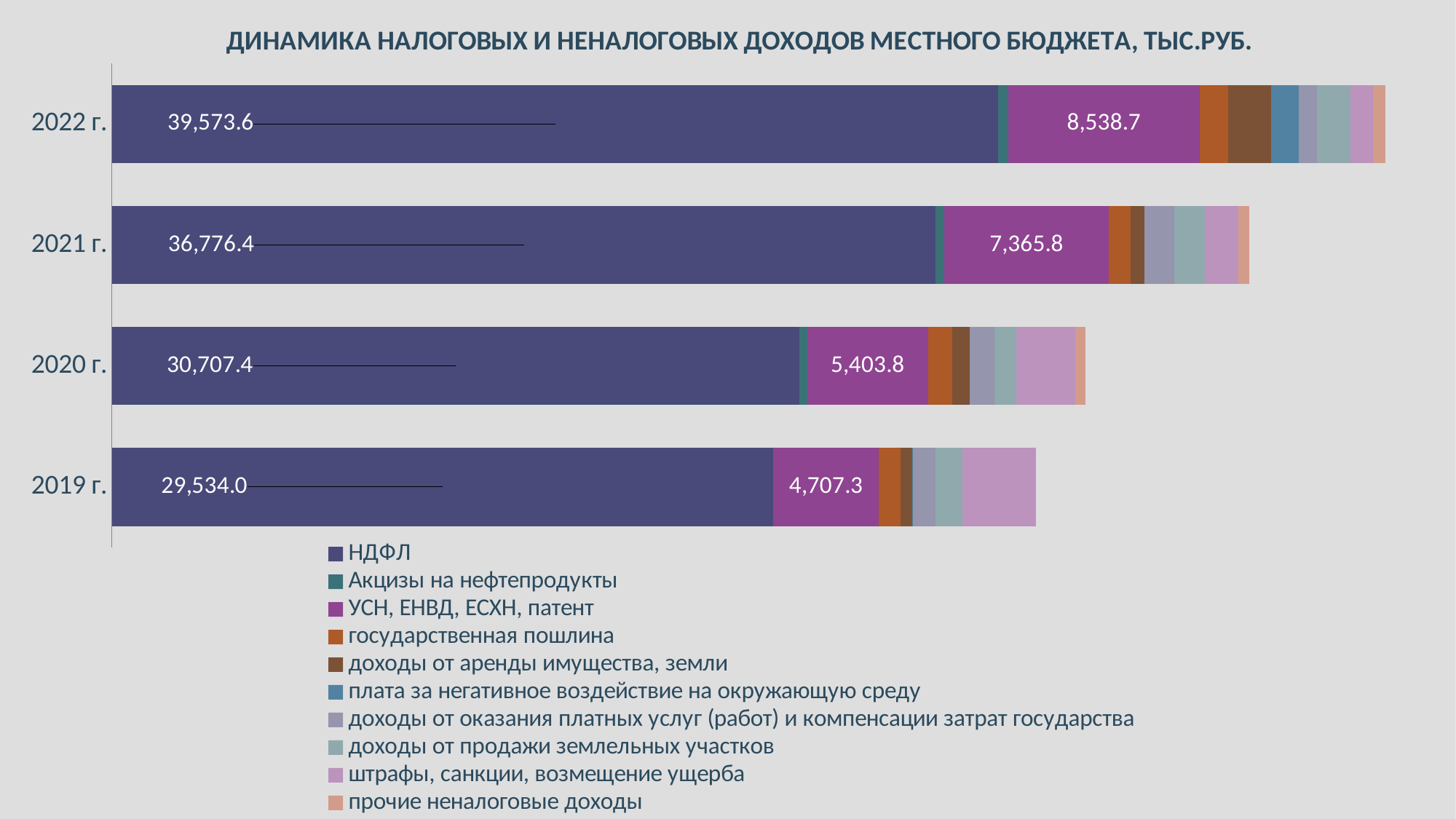
Which year has the larger НДФЛ value, 2020 г. or 2019 г.? 2020 г. What is the value of НДФЛ for 2019 г.? 29,534.0 What kind of chart is shown on the slide? Stacked bar chart In which year is the НДФЛ value the highest? 2022 г. What is the value of УСН, ЕНВД, ЕСХН, патент for 2021 г.? 7,365.8 What is the value of УСН, ЕНВД, ЕСХН, патент for 2020 г.? 5,403.8 Does the НДФЛ value increase or decrease from 2019 г. to 2022 г.? Increase What is the difference between the НДФЛ values for 2022 г. and 2021 г.? 2,797.2 How many years are shown on the chart? 4 How many series does the legend list? 10 What is the value of НДФЛ for 2022 г.? 39,573.6 In which year is the УСН, ЕНВД, ЕСХН, патент value the lowest? 2019 г.